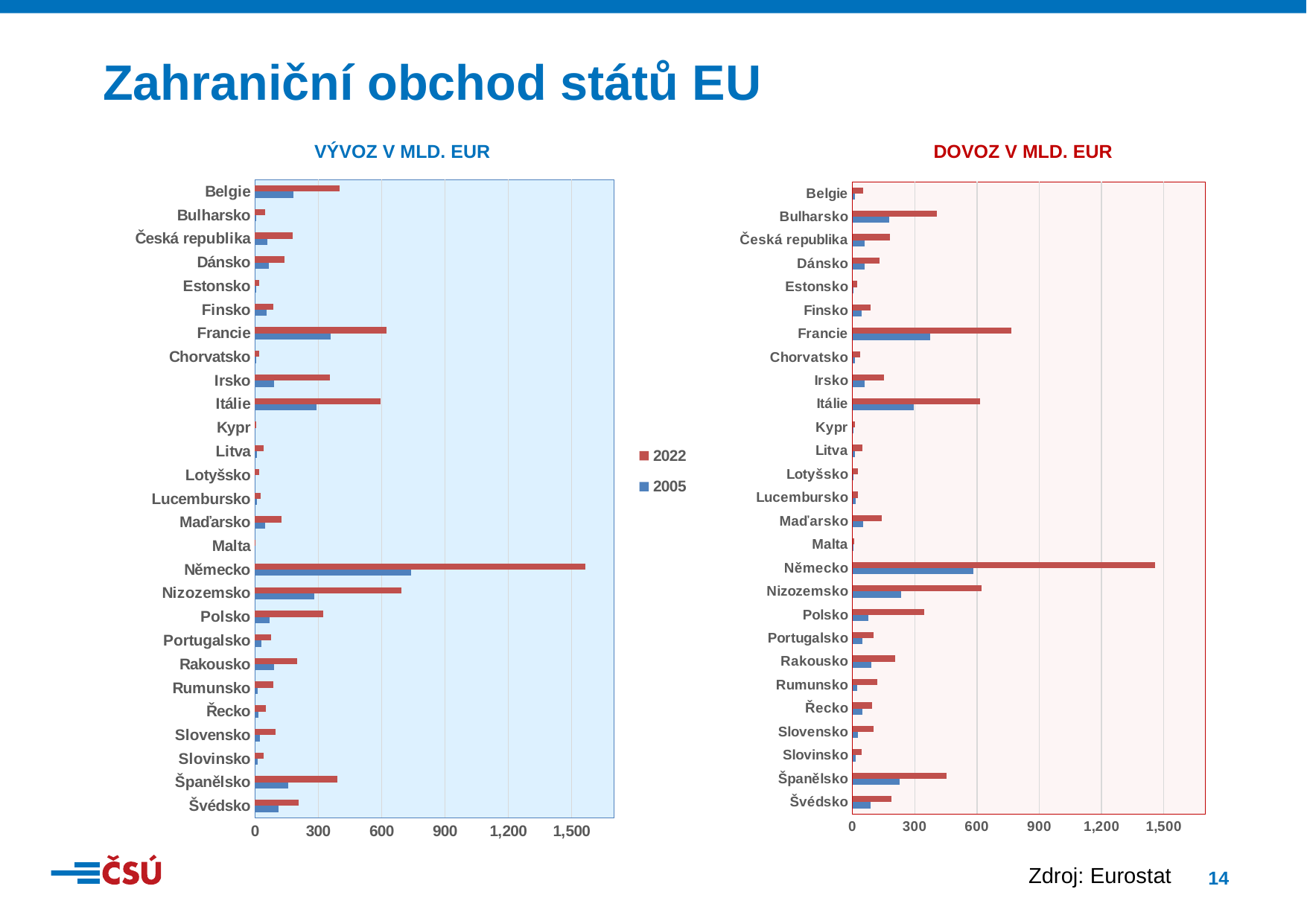
What kind of chart is the VÝVOZ V MLD. EUR chart? bar chart In the VÝVOZ V MLD. EUR chart, which country has the highest value for 2022? Německo How many series does the legend list? 2 In the VÝVOZ V MLD. EUR chart, is the 2022 value for Nizozemsko greater or less than 600? greater In the DOVOZ V MLD. EUR chart, is the 2022 value for Německo greater or less than 1,500? less In the DOVOZ V MLD. EUR chart, is the 2022 value for Španělsko greater or less than 300? greater In the DOVOZ V MLD. EUR chart, which is larger for 2022: Francie or Nizozemsko? Francie In the DOVOZ V MLD. EUR chart, which country has the highest value for 2022? Německo Which colour represents the 2005 series in the legend? blue How many countries are shown on the DOVOZ V MLD. EUR chart? 27 In the DOVOZ V MLD. EUR chart, which is larger for 2022: Polsko or Rakousko? Polsko